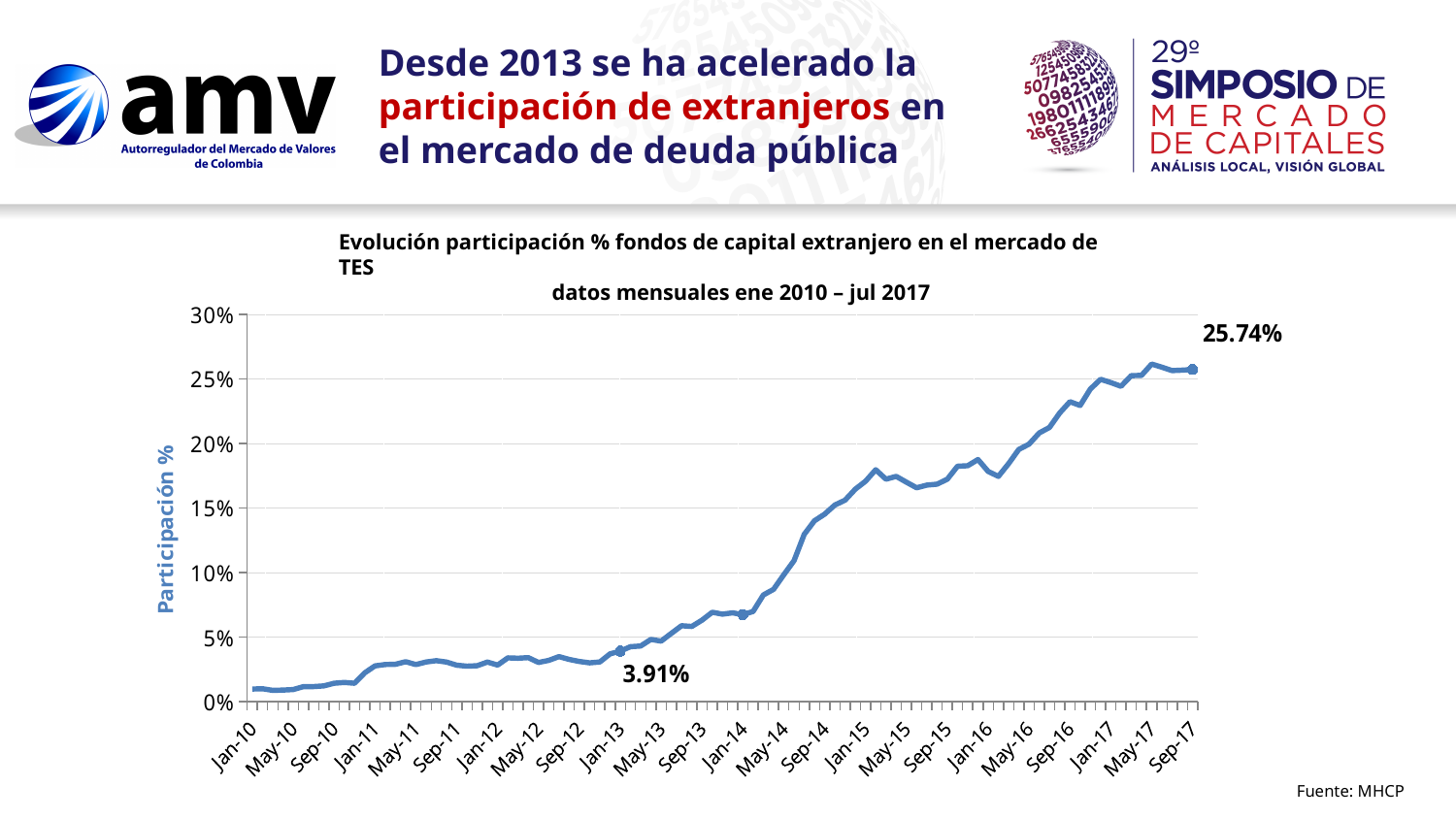
Is the value for Jan-12 greater or less than 5%? less Is the value for Jan-16 greater or less than 15%? greater What kind of chart is shown on the slide? line chart What is the labelled participation value at the end of the series (July 2017)? 25.74% By how many percentage points does the labelled value at the end of the series (25.74%) exceed the labelled value at Jan-13 (3.91%)? 21.83 percentage points Overall, does the participation of foreign capital funds rise or fall from Jan-10 to Sep-17? rise What is the labelled participation value at the start of 2013 (Jan-13)? 3.91% Which is larger, the value for Jan-15 or the value for Jan-13? Jan-15 What source is cited for the chart data? MHCP Is the value for Jan-10 greater or less than 5%? less What is the title of the vertical axis? Participación %